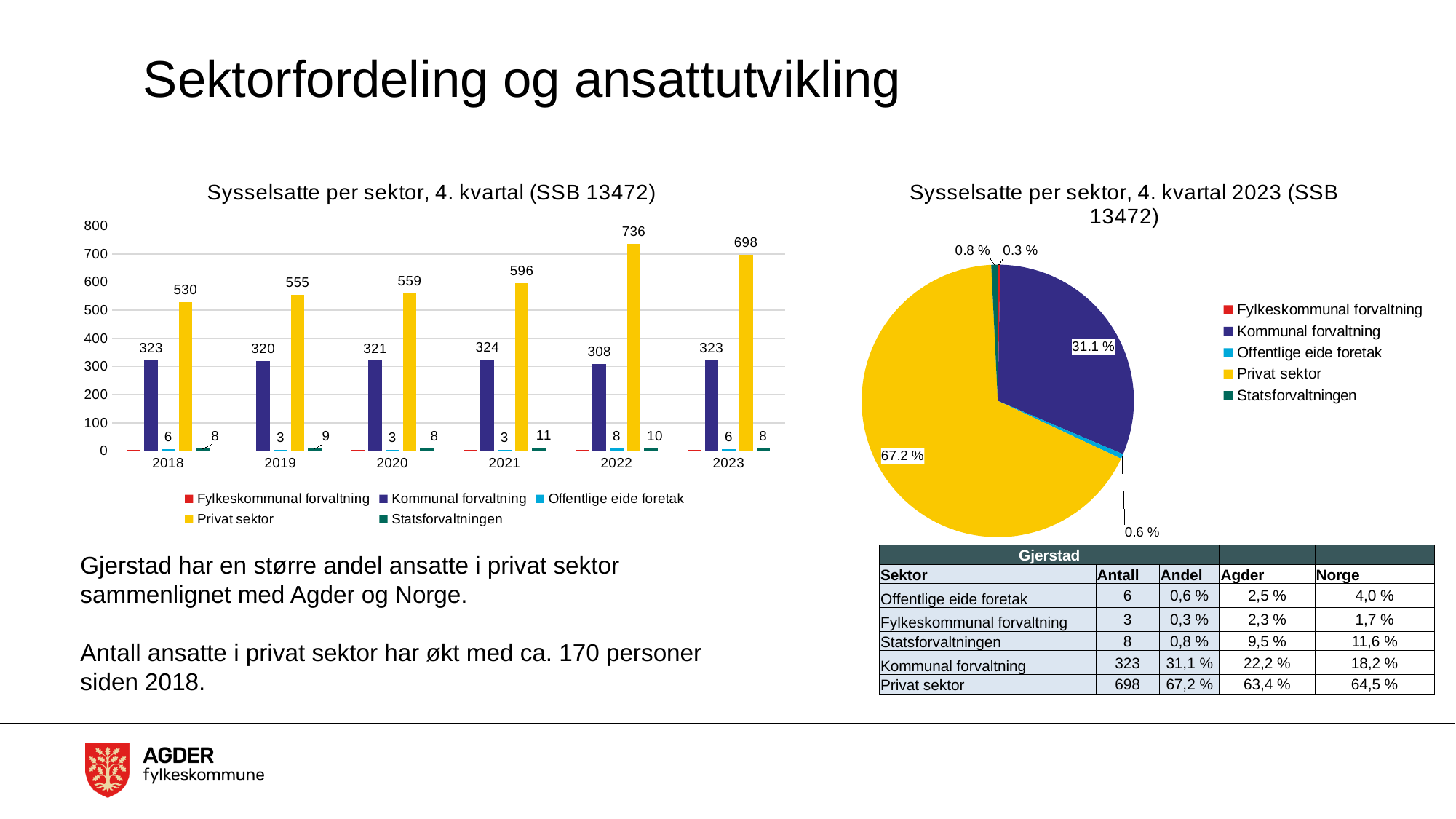
What kind of chart is the chart on the right titled 'Sysselsatte per sektor, 4. kvartal 2023 (SSB 13472)'? Pie chart In the bar chart 'Sysselsatte per sektor, 4. kvartal (SSB 13472)', in which year is the Privat sektor value highest? 2022 How many years are shown on the x axis of the bar chart 'Sysselsatte per sektor, 4. kvartal (SSB 13472)'? 6 In the bar chart 'Sysselsatte per sektor, 4. kvartal (SSB 13472)', in which year is the Kommunal forvaltning value lowest? 2022 In the bar chart 'Sysselsatte per sektor, 4. kvartal (SSB 13472)', what is the value for Privat sektor in 2022? 736 In the bar chart 'Sysselsatte per sektor, 4. kvartal (SSB 13472)', what is the difference between the Privat sektor values in 2023 and 2018? 168 In the bar chart 'Sysselsatte per sektor, 4. kvartal (SSB 13472)', which is larger: Statsforvaltningen in 2021 or Offentlige eide foretak in 2021? Statsforvaltningen in 2021 How many series does the legend of the bar chart 'Sysselsatte per sektor, 4. kvartal (SSB 13472)' list? 5 In the pie chart 'Sysselsatte per sektor, 4. kvartal 2023 (SSB 13472)', which sector has the largest slice? Privat sektor In the bar chart 'Sysselsatte per sektor, 4. kvartal (SSB 13472)', what is the value for Kommunal forvaltning in 2020? 321 In the pie chart 'Sysselsatte per sektor, 4. kvartal 2023 (SSB 13472)', what share does Kommunal forvaltning have? 31.1 % In the bar chart 'Sysselsatte per sektor, 4. kvartal (SSB 13472)', is the value for Privat sektor in 2019 greater or less than 500? greater